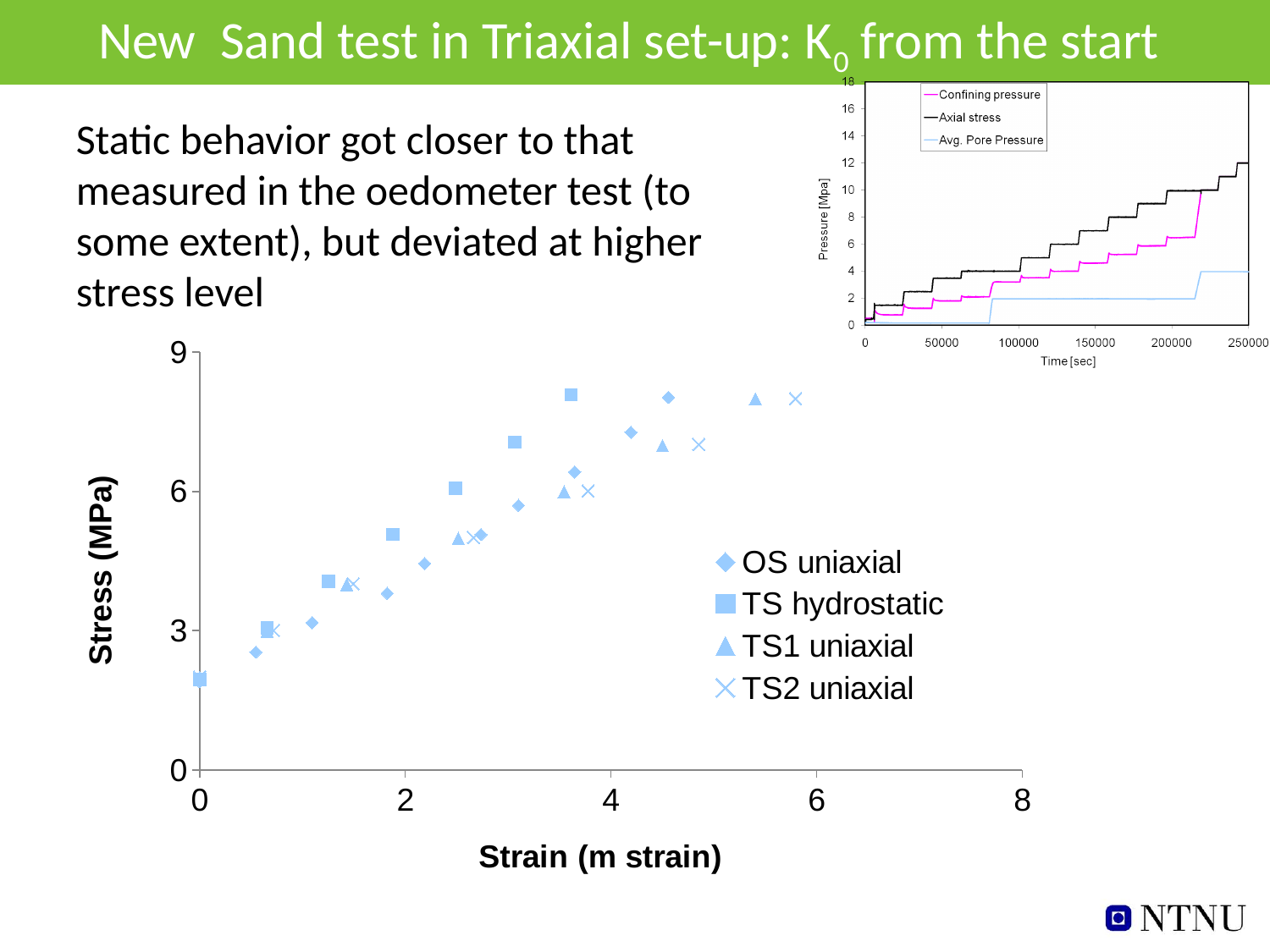
In the Stress versus Strain chart, is the lowest stress value of the OS uniaxial series greater or less than 3? less How many series does the legend of the Stress versus Strain chart list? 4 In the Stress versus Strain chart, do the stress values rise or fall as strain increases? rise In the Stress versus Strain chart, what is the label of the y axis? Stress (MPa) What kind of chart is the large chart of Stress versus Strain? scatter chart In the Stress versus Strain chart, what is the label of the x axis? Strain (m strain) In the small Pressure versus Time chart, is the Axial stress value at 250000 sec greater or less than 10? greater In the Stress versus Strain chart, is the highest stress value of the TS hydrostatic series greater or less than 6? greater In the small Pressure versus Time chart, which series reaches the highest pressure? Axial stress In the Stress versus Strain chart, which series is plotted with square markers? TS hydrostatic How many series does the legend of the small Pressure versus Time chart list? 3 What kind of chart is the small chart of Pressure versus Time in the top right? line chart